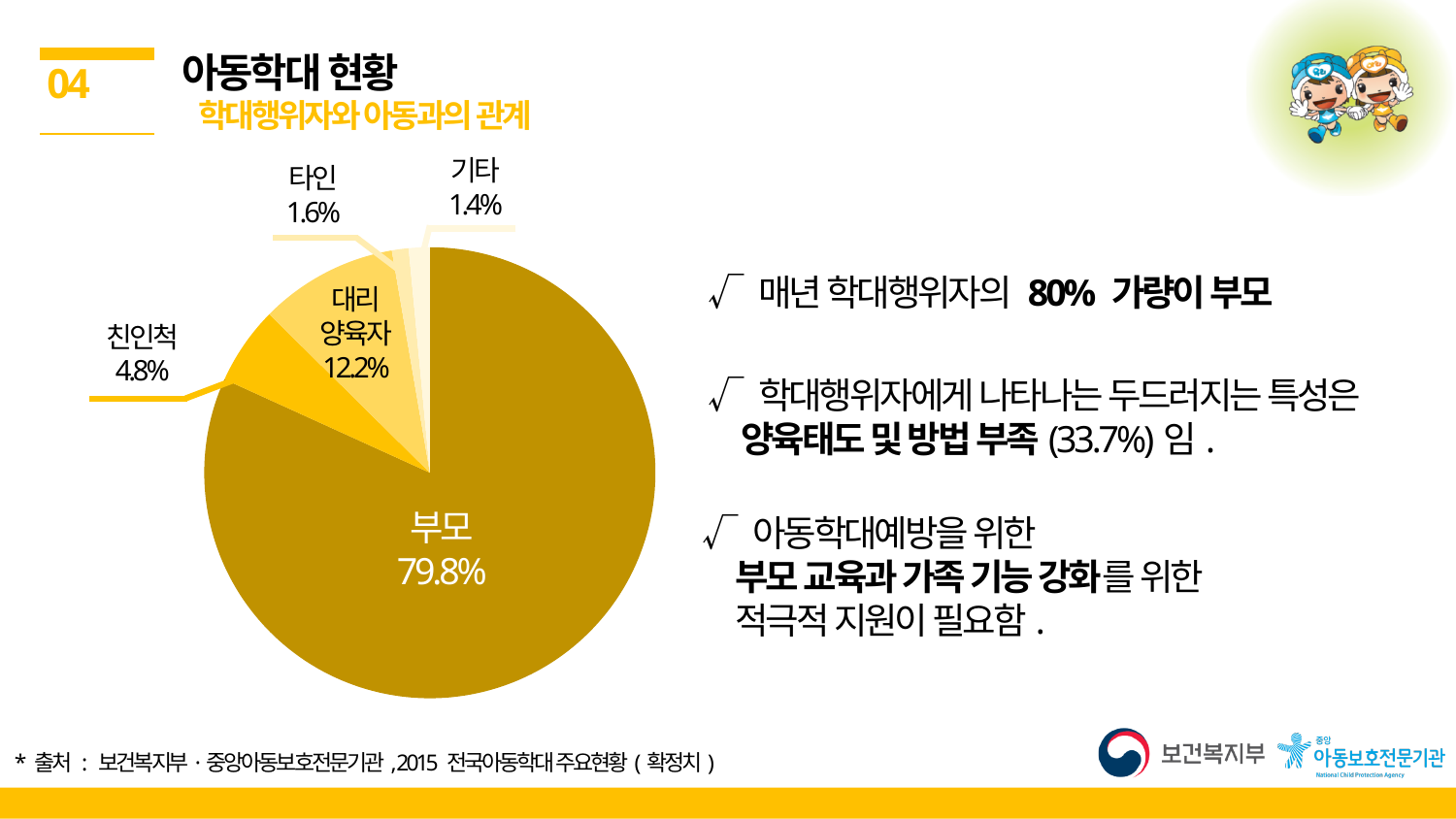
What is the value shown for 대리 양육자? 12.2% What is the difference between the values for 부모 and 대리 양육자? 67.6% What kind of chart is shown on the slide? pie chart How many categories are shown in the pie chart? 5 What share of the pie does 부모 account for? 79.8% Which is larger, the value for 친인척 or the value for 타인? 친인척 Which category has the largest slice of the pie? 부모 What is the subtitle of the chart on the slide? 학대행위자와 아동과의 관계 What is the value shown for 기타? 1.4% Which category has the smallest slice of the pie? 기타 What is the value shown for 타인? 1.6% What is the value shown for 친인척? 4.8%